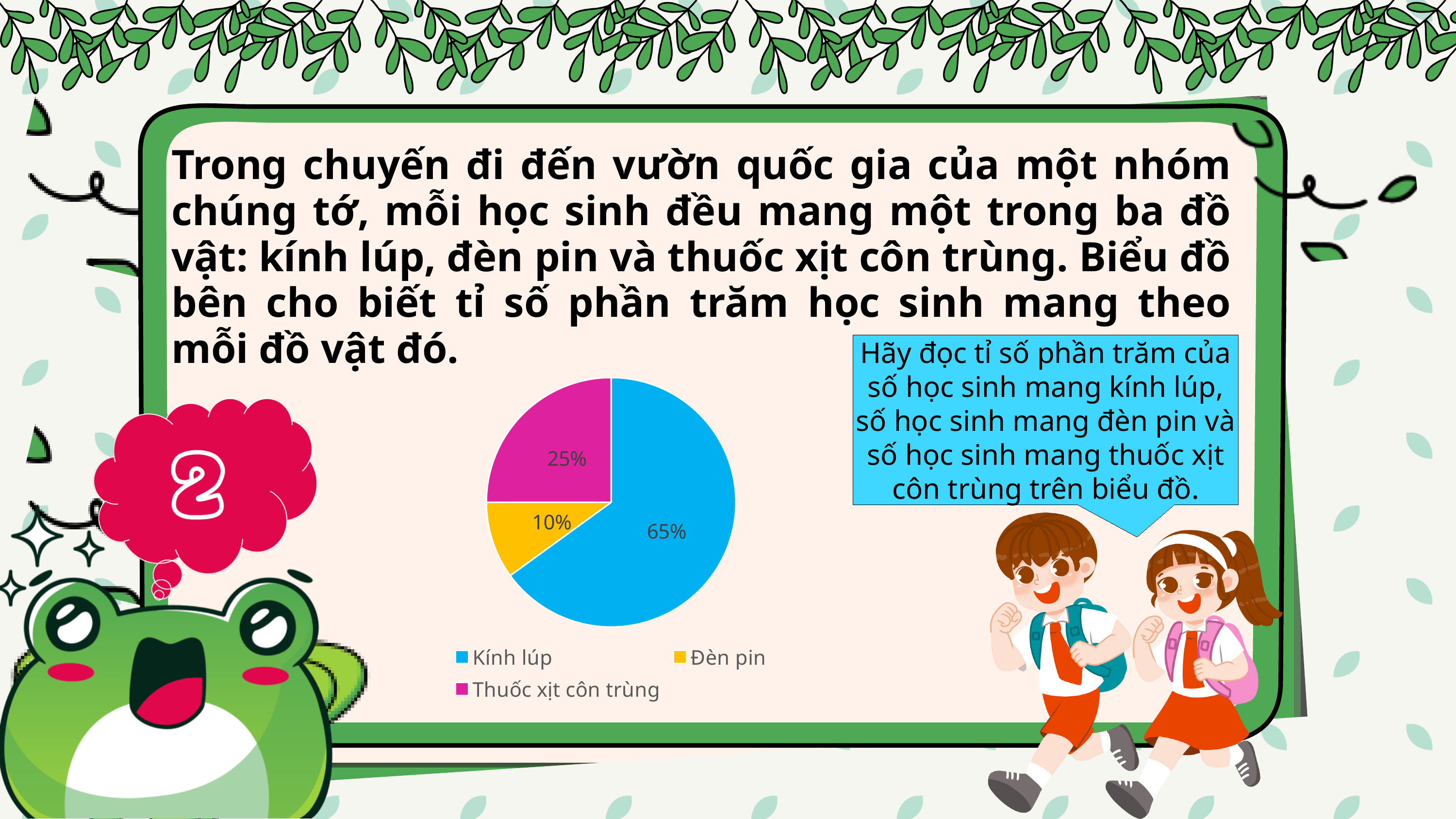
Which item has the smallest share of the pie? Đèn pin What colour is the slice for Kính lúp? blue What percentage of students brought Thuốc xịt côn trùng? 25% What is the difference in percentage points between Kính lúp and Thuốc xịt côn trùng? 40% What percentage of students brought Đèn pin? 10% Which is larger, the share for Đèn pin or the share for Thuốc xịt côn trùng? Thuốc xịt côn trùng What colour is the slice for Đèn pin? yellow What kind of chart is shown on the slide? pie chart How many categories does the pie chart show? 3 What percentage of students brought Kính lúp? 65% Which item has the largest share of the pie? Kính lúp What is the difference in percentage points between Thuốc xịt côn trùng and Đèn pin? 15%